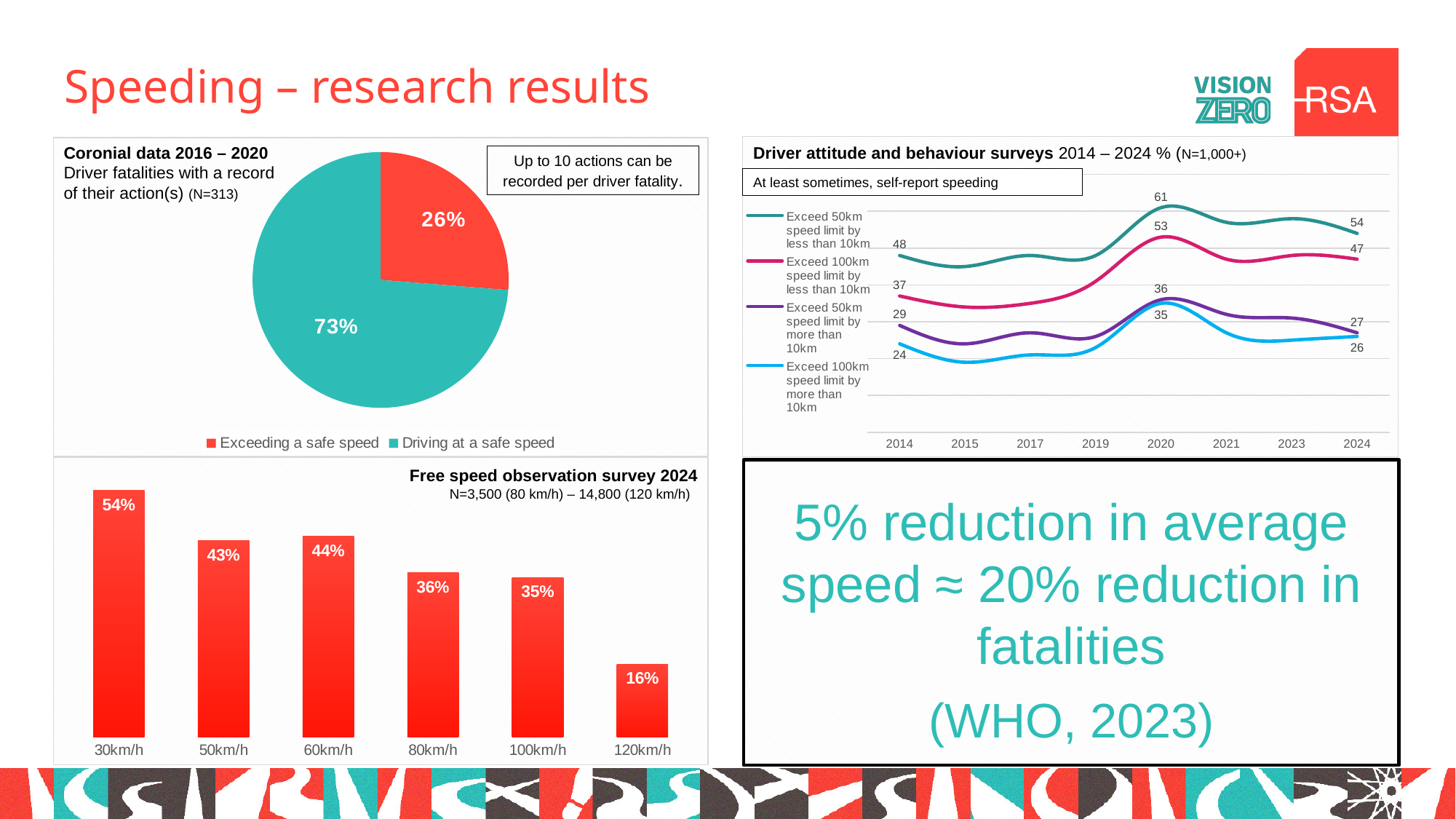
What kind of chart is the Free speed observation survey 2024 chart? Bar chart In the Driver attitude and behaviour surveys chart, what is the 2020 value for 'Exceed 50km speed limit by less than 10km'? 61 In the Coronial data 2016 – 2020 pie chart, what share of driver fatalities is labelled 'Exceeding a safe speed'? 26% In the Free speed observation survey 2024 chart, which speed category has the lowest value? 120km/h What kind of chart is the Coronial data 2016 – 2020 chart? Pie chart In the Driver attitude and behaviour surveys chart, which is larger in 2024: 'Exceed 100km speed limit by less than 10km' or 'Exceed 50km speed limit by more than 10km'? Exceed 100km speed limit by less than 10km In the Free speed observation survey 2024 chart, what is the difference between the values for 30km/h and 120km/h? 38% In the Free speed observation survey 2024 chart, which speed category has the highest value? 30km/h In the Driver attitude and behaviour surveys chart, how many series does the legend list? 4 In the Free speed observation survey 2024 chart, what is the value for 80km/h? 36% In the Coronial data 2016 – 2020 pie chart, what share is labelled 'Driving at a safe speed'? 73% In the Free speed observation survey 2024 chart, how many speed categories are shown? 6